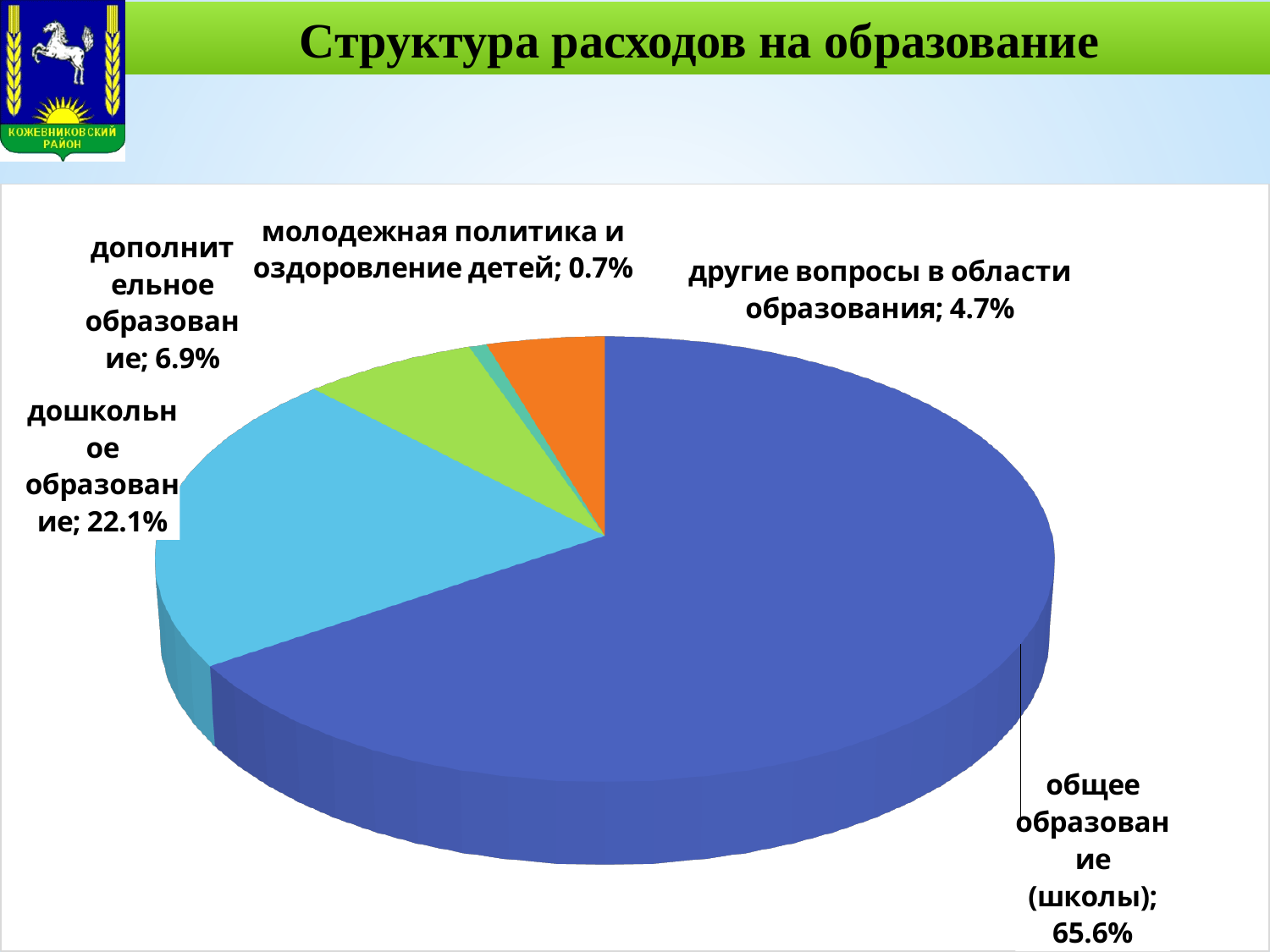
Which category has the largest share of education expenditure? общее образование (школы) Which category has the smallest share of education expenditure? молодежная политика и оздоровление детей What share of education expenditure goes to молодежная политика и оздоровление детей? 0.7% How many categories are shown in the pie chart? 5 Which is larger: the share for дополнительное образование or for другие вопросы в области образования? дополнительное образование What share of education expenditure goes to дополнительное образование? 6.9% What share of education expenditure goes to другие вопросы в области образования? 4.7% What is the difference in percentage points between общее образование (школы) and дошкольное образование? 43.5 What share of education expenditure goes to общее образование (школы)? 65.6% What type of chart is shown on the slide? pie chart What is the title of the slide? Структура расходов на образование What share of education expenditure goes to дошкольное образование? 22.1%